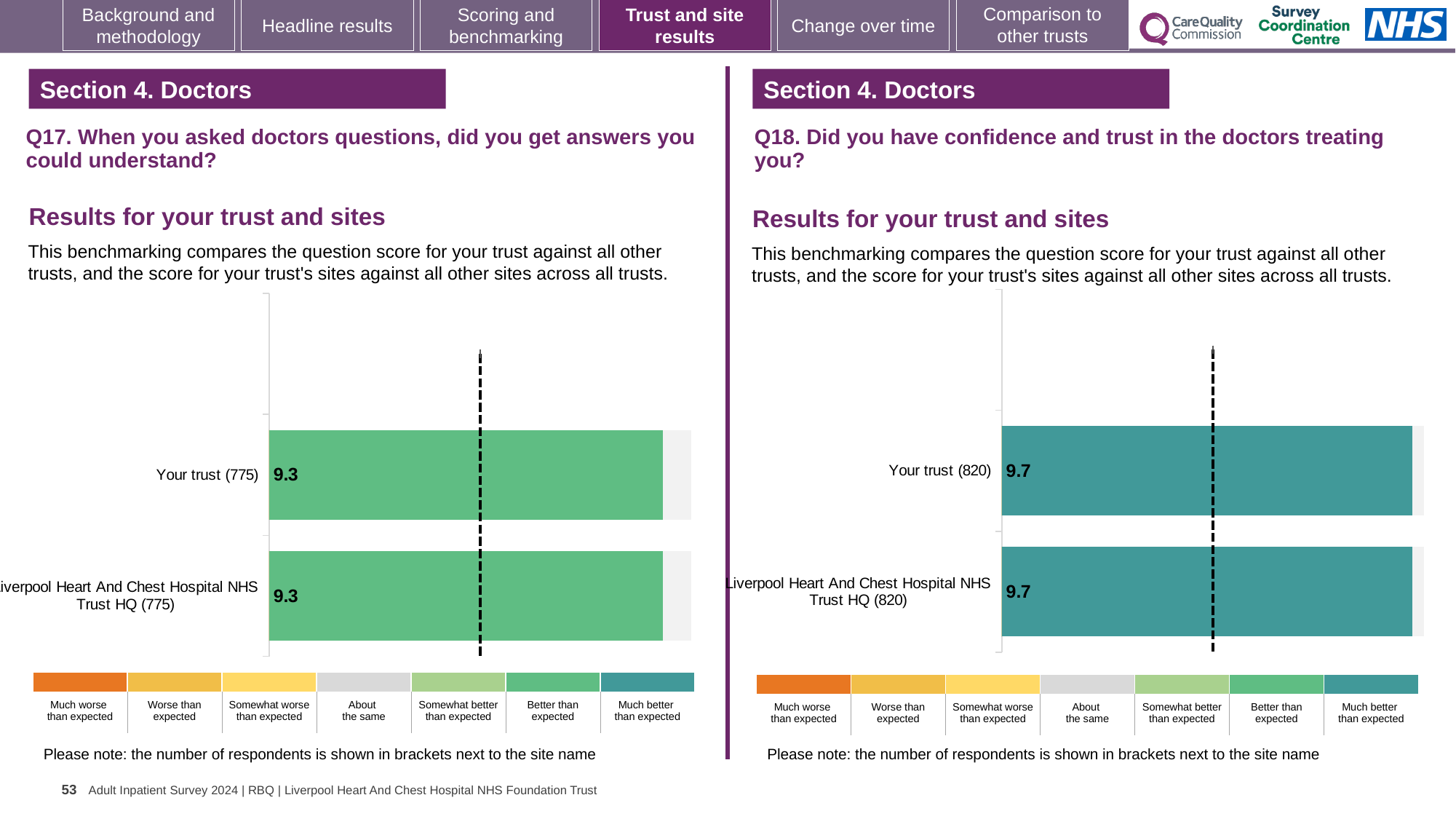
How many bars are plotted in the Q18 chart on the right? 2 In the Q17 chart on the left, what is the score for Your trust (775)? 9.3 In the Q17 chart on the left, which benchmark category does the bar colour correspond to according to the legend? Better than expected In the Q18 chart on the right, what is the score for Your trust (820)? 9.7 How many bars are plotted in the Q17 chart on the left? 2 Which is larger: the Your trust score in the Q17 chart on the left or the Your trust score in the Q18 chart on the right? Q18 (9.7) In the Q17 chart on the left, what is the score for Liverpool Heart And Chest Hospital NHS Trust HQ (775)? 9.3 In the Q18 chart on the right, what is the score for Liverpool Heart And Chest Hospital NHS Trust HQ (820)? 9.7 In the Q18 chart on the right, what is the difference between the score for Your trust and the score for Liverpool Heart And Chest Hospital NHS Trust HQ? 0.0 What type of chart is used for the Q18 results on the right? Bar chart In the Q17 chart on the left, what is the difference between the score for Your trust and the score for Liverpool Heart And Chest Hospital NHS Trust HQ? 0.0 In the Q18 chart on the right, which benchmark category does the bar colour correspond to according to the legend? Much better than expected